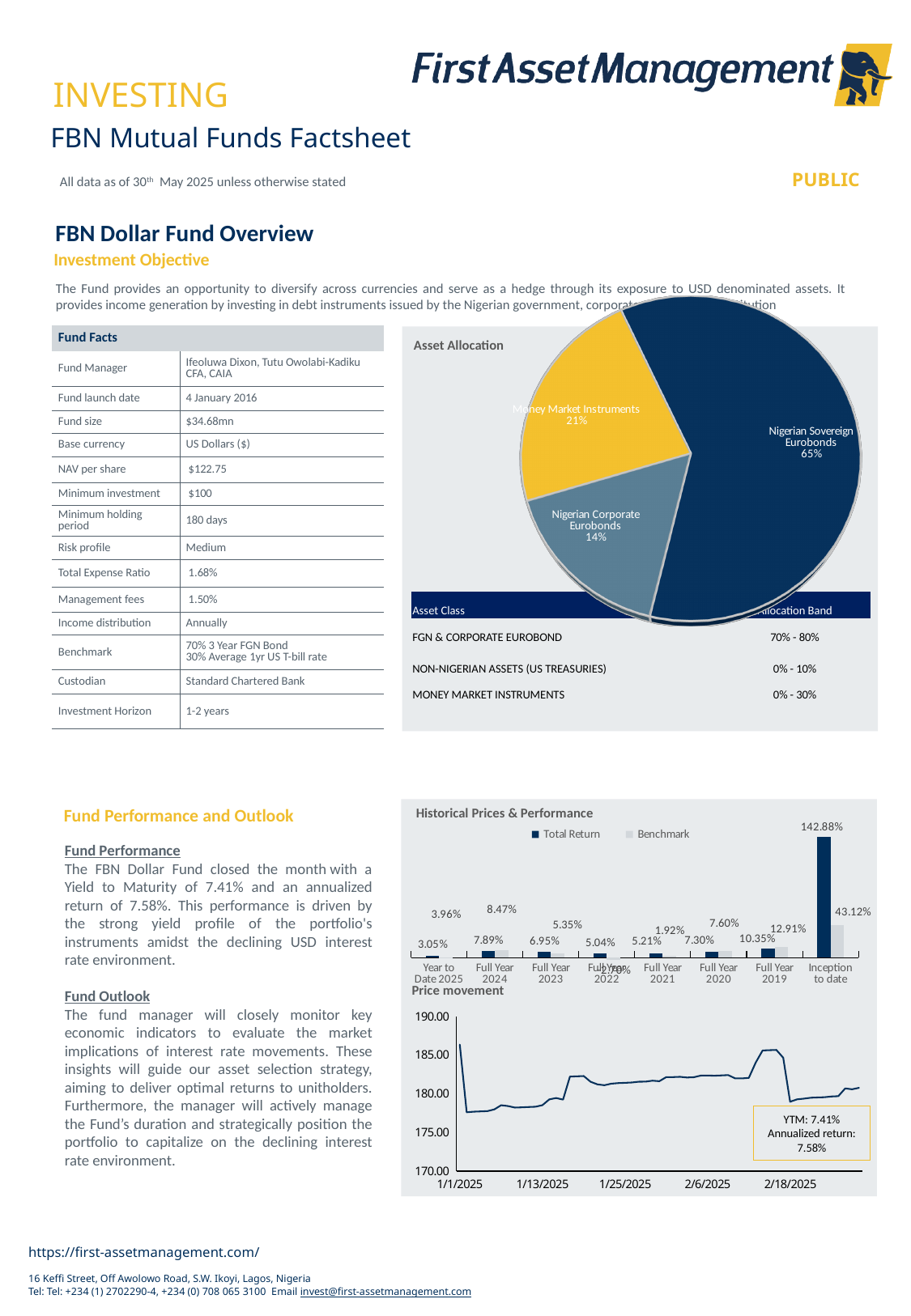
What kind of chart is the Price movement chart? Line chart How many slices does the Asset Allocation pie chart have? 3 In the Historical Prices & Performance chart, how many series does the legend list? 2 In the Historical Prices & Performance chart, what is the Benchmark value for Full Year 2019? 12.91% In the Asset Allocation pie chart, what share of the fund is in Nigerian Sovereign Eurobonds? 65% In the Historical Prices & Performance chart, what is the difference between Total Return and Benchmark for Inception to date? 99.76% In the Price movement chart, is the value at 1/1/2025 greater or less than 180.00? greater In the Historical Prices & Performance chart, which is larger for Full Year 2023, Total Return or Benchmark? Total Return In the Asset Allocation pie chart, what share is Money Market Instruments? 21% In the Asset Allocation pie chart, which asset class has the smallest slice? Nigerian Corporate Eurobonds In the Historical Prices & Performance chart, what is the Total Return for Full Year 2024? 7.89% In the Historical Prices & Performance chart, what is the Total Return for Inception to date? 142.88%